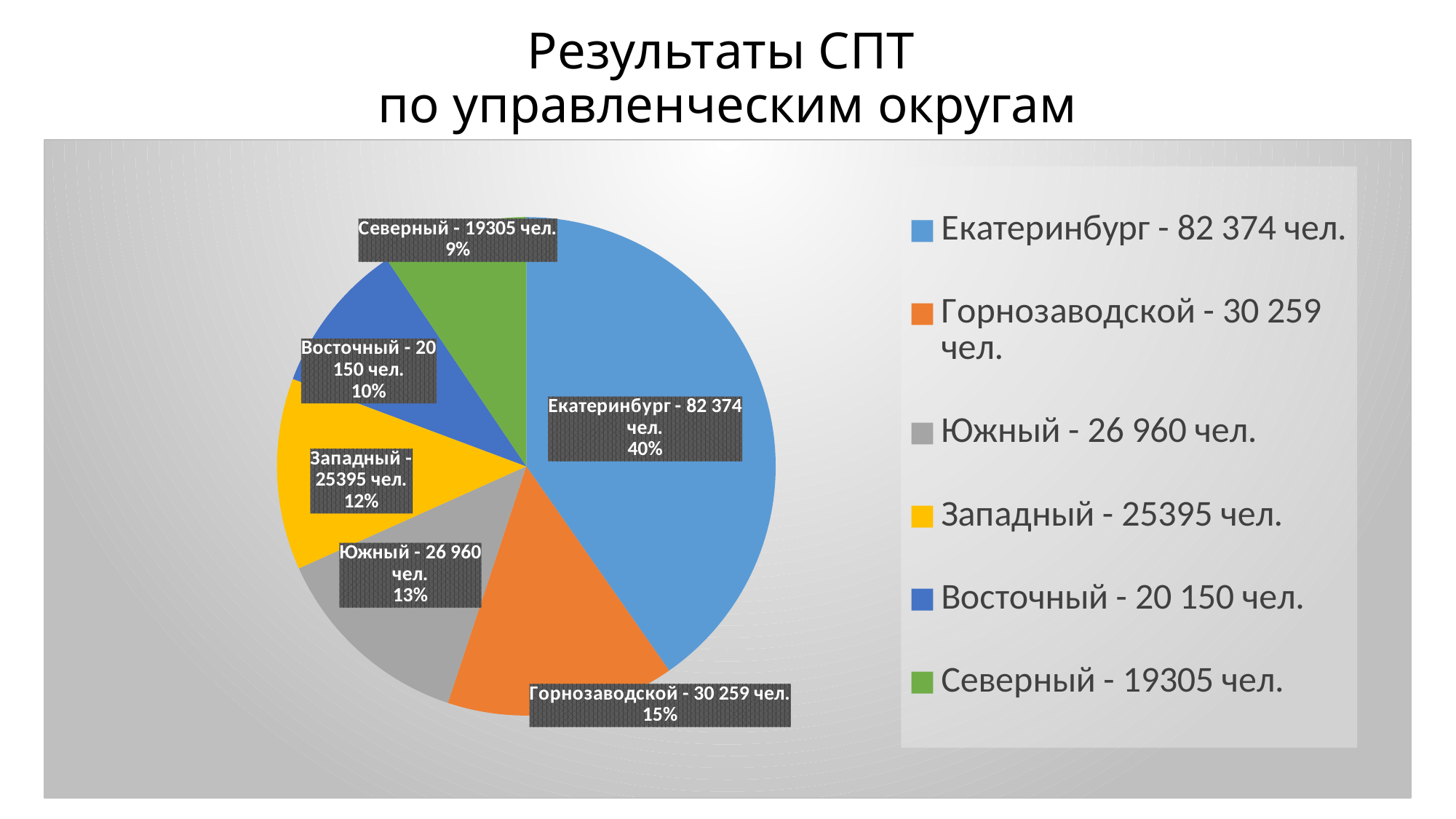
What share of the pie does Горнозаводской account for? 15% What share of the pie does Северный account for? 9% What is the difference between the values for Екатеринбург and Горнозаводской? 52 115 чел. What is the value shown for Восточный? 20 150 чел. How many slices does the pie chart have? 6 Which is larger, the value for Горнозаводской or the value for Южный? Горнозаводской Which district has the largest slice of the pie? Екатеринбург Which district has the smallest slice of the pie? Северный What is the title of the slide? Результаты СПТ по управленческим округам What kind of chart is shown on the slide? Pie chart What is the value shown for Екатеринбург? 82 374 чел. How many entries does the legend list? 6